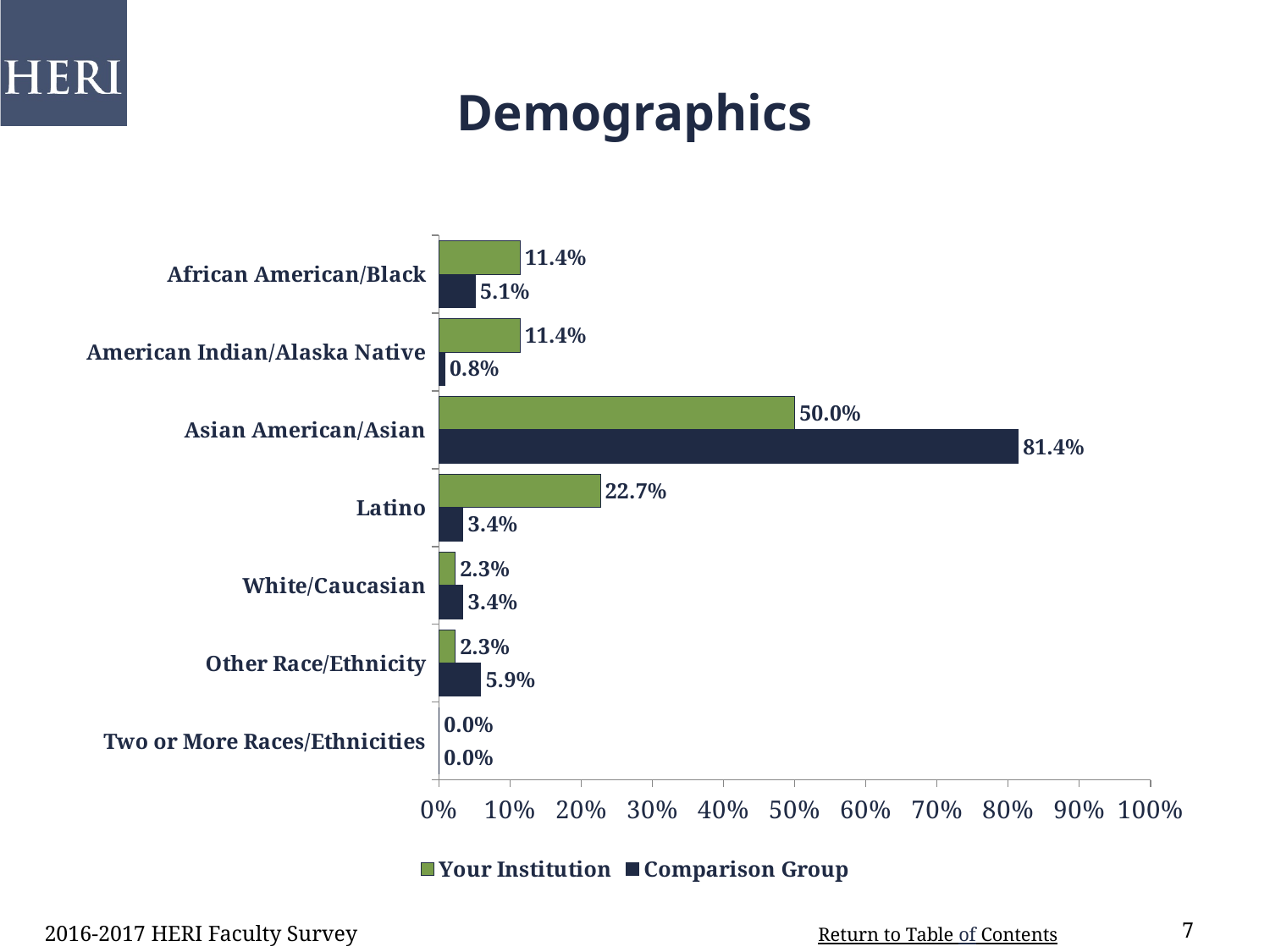
How many series does the legend list? 2 Which is larger for African American/Black: Your Institution or Comparison Group? Your Institution What is the value for Your Institution for Asian American/Asian? 50.0% What is the difference between the Comparison Group and Your Institution values for Other Race/Ethnicity? 3.6% How many categories are shown on the chart? 7 What is the difference between the Comparison Group and Your Institution values for Asian American/Asian? 31.4% What is the value for Comparison Group for Latino? 3.4% Which category has the lowest value for Your Institution? Two or More Races/Ethnicities What is the title of the chart? Demographics Which category has the highest value for Comparison Group? Asian American/Asian What kind of chart is shown on the slide? Bar chart What is the value for Comparison Group for American Indian/Alaska Native? 0.8%